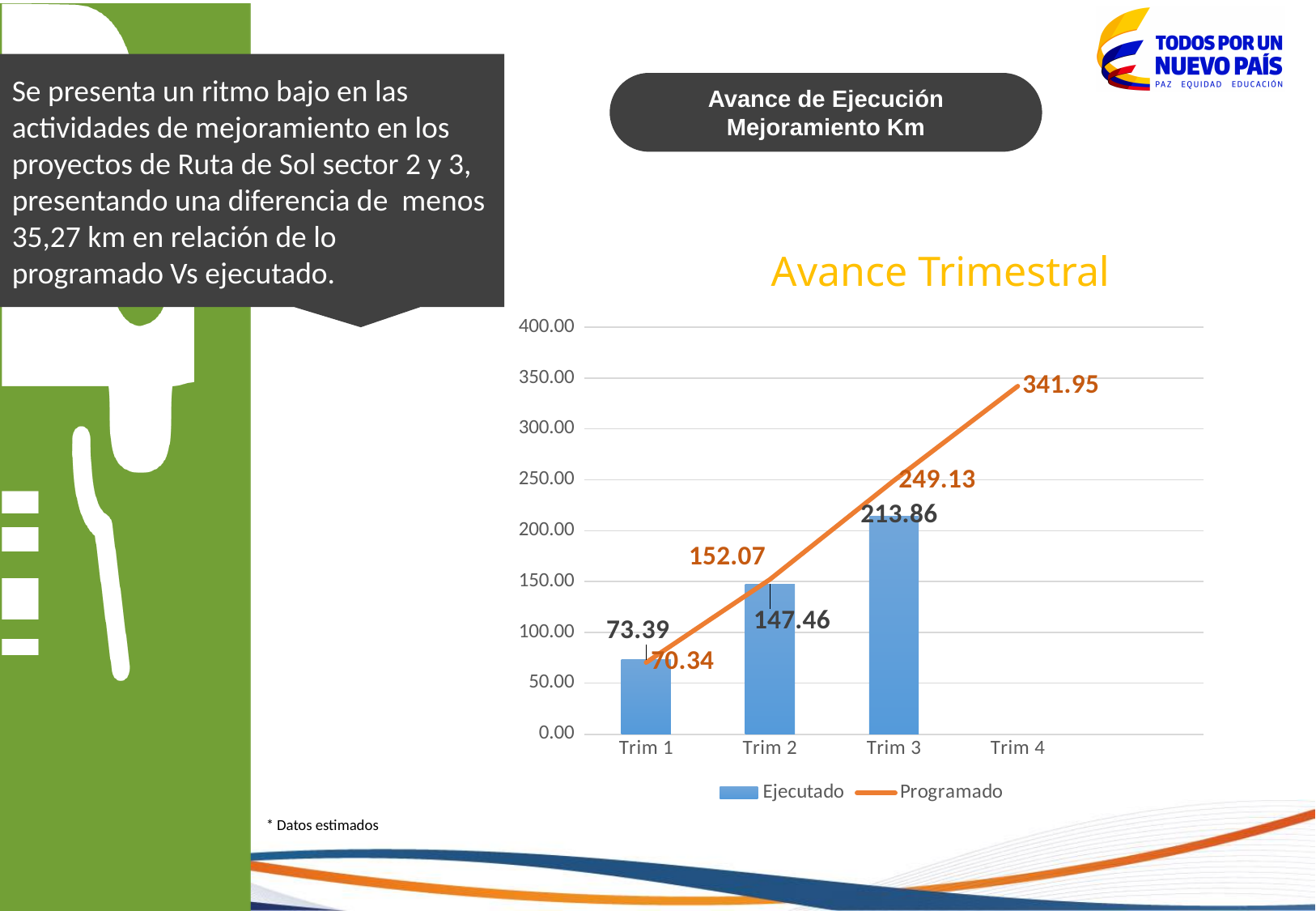
Does the Programado line rise or fall from Trim 1 to Trim 4? Rises What is the difference between the Programado and Ejecutado values for Trim 3? 35.27 How many series does the legend list? 2 By how much does the Programado value increase from Trim 3 to Trim 4? 92.82 What is the title of the chart? Avance Trimestral Which quarter has the lowest Ejecutado value? Trim 1 For Trim 1, which is larger: the Ejecutado value or the Programado value? Ejecutado What is the Ejecutado value for Trim 3? 213.86 What is the Programado value for Trim 4? 341.95 What is the Ejecutado value for Trim 2? 147.46 What is the Programado value for Trim 1? 70.34 Which quarter has the highest Programado value? Trim 4